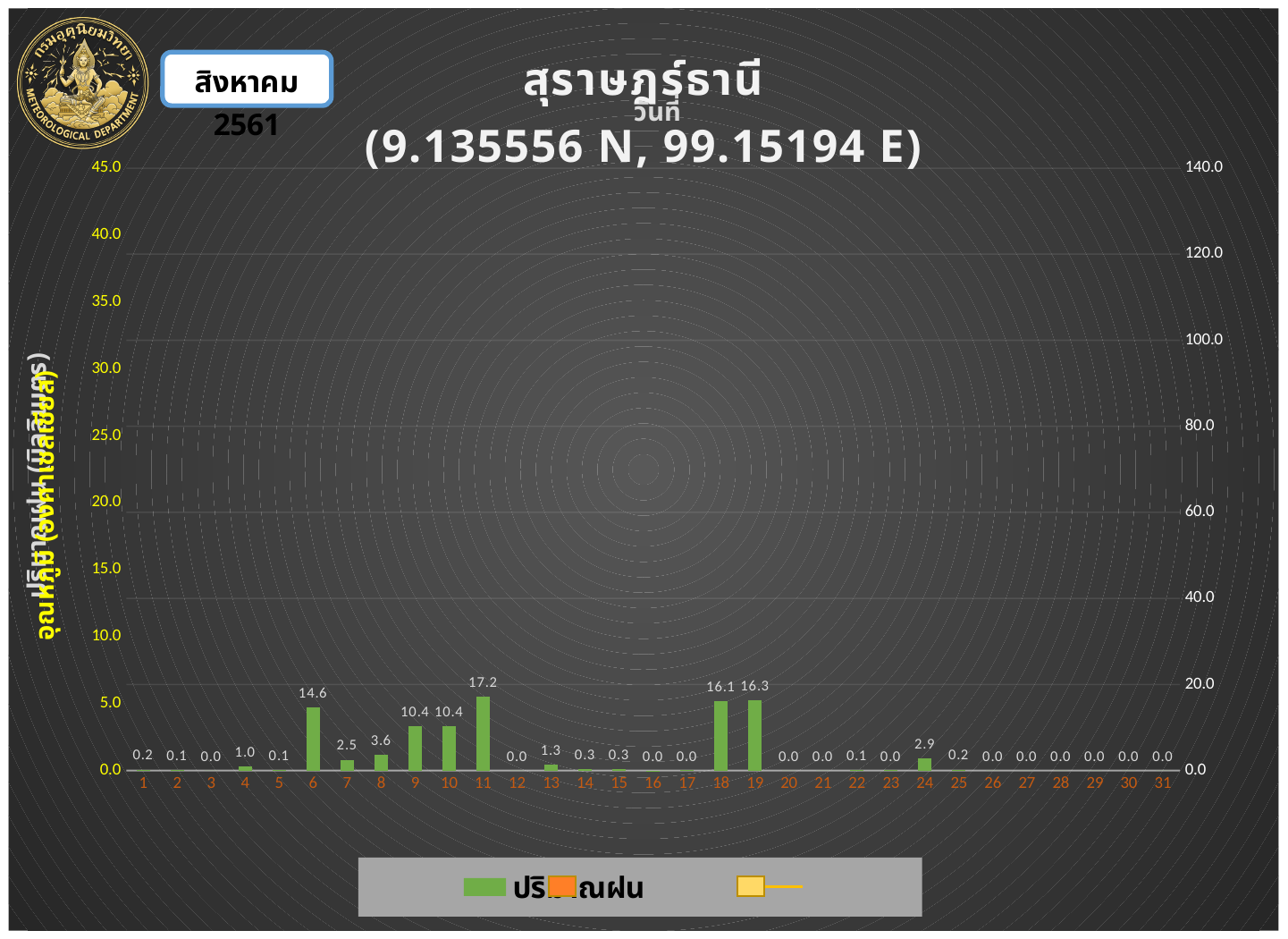
How many days are shown along the x axis? 31 Which is larger, the value for day 8 or the value for day 7? day 8 Which day has the highest bar on the chart? 11 What kind of chart is used to show the rainfall values? bar chart What is the value labelled for day 6? 14.6 What is the value labelled for day 24? 2.9 Which is larger, the value for day 9 or the value for day 13? day 9 What is the difference between the values for day 11 and day 6? 2.6 What is the value labelled for day 19? 16.3 What coordinates are given in the chart title? 9.135556 N, 99.15194 E What is the rainfall value shown for day 11? 17.2 What is the difference between the values for day 19 and day 18? 0.2